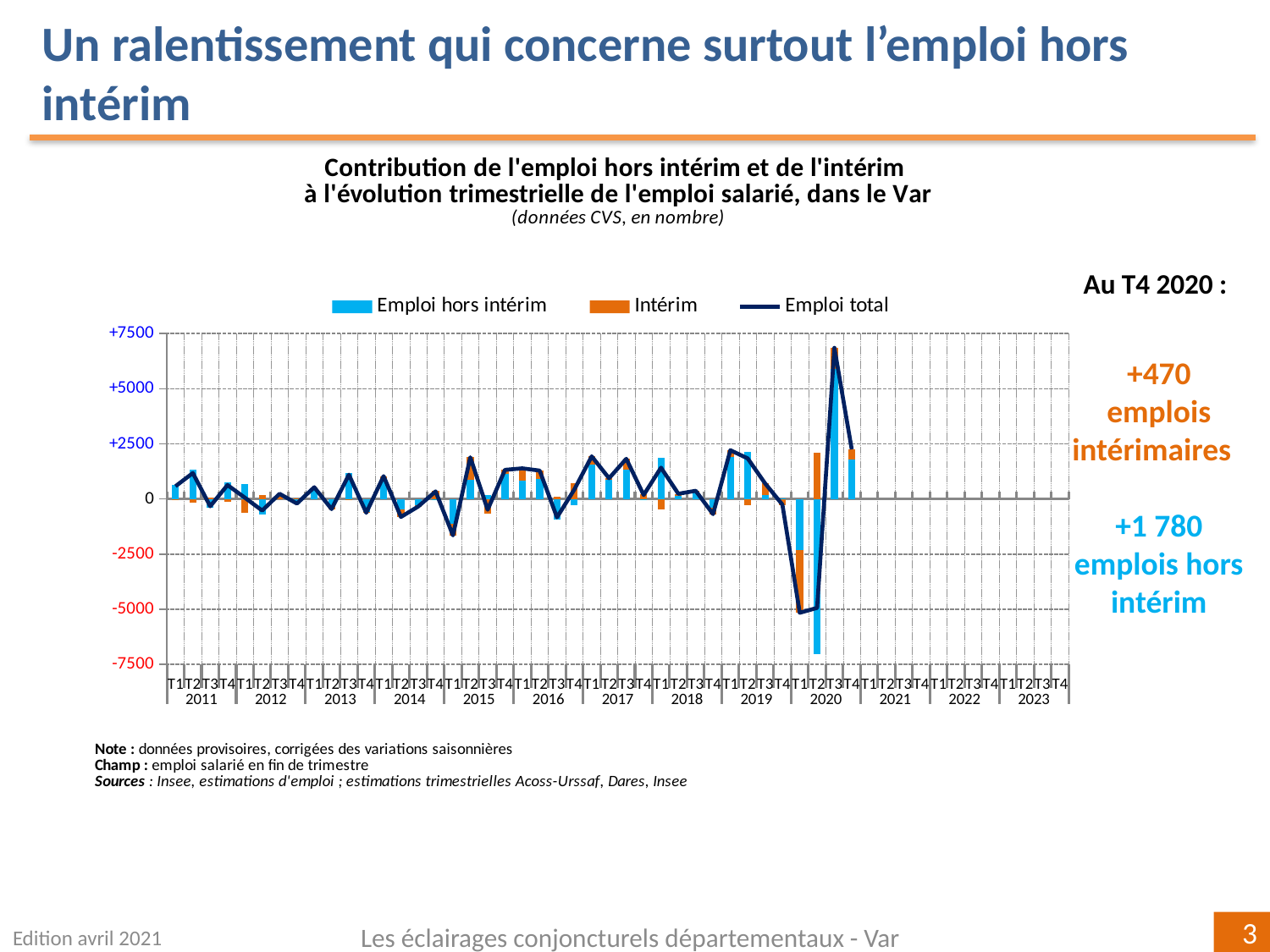
Is the value of Emploi total at T2 2020 greater or less than -2500? less Is the value of Emploi total at T3 2020 greater or less than +5000? greater In which quarter does Emploi total reach its highest value? T3 2020 What kind of chart is shown on the slide? A combined bar and line chart According to the slide, what is the contribution of emploi hors intérim at T4 2020? +1 780 How many series does the chart legend list? 3 According to the slide, what is the contribution of intérim employment at T4 2020? +470 What is the total contribution (hors intérim plus intérim) at T4 2020? +2 250 Is the value of Emploi hors intérim at T2 2020 greater or less than -5000? less At T4 2020, which is larger: the contribution of emploi hors intérim or of intérim? Emploi hors intérim In which quarter does Emploi hors intérim reach its lowest value? T2 2020 What colour represents the Intérim series in the chart? Orange